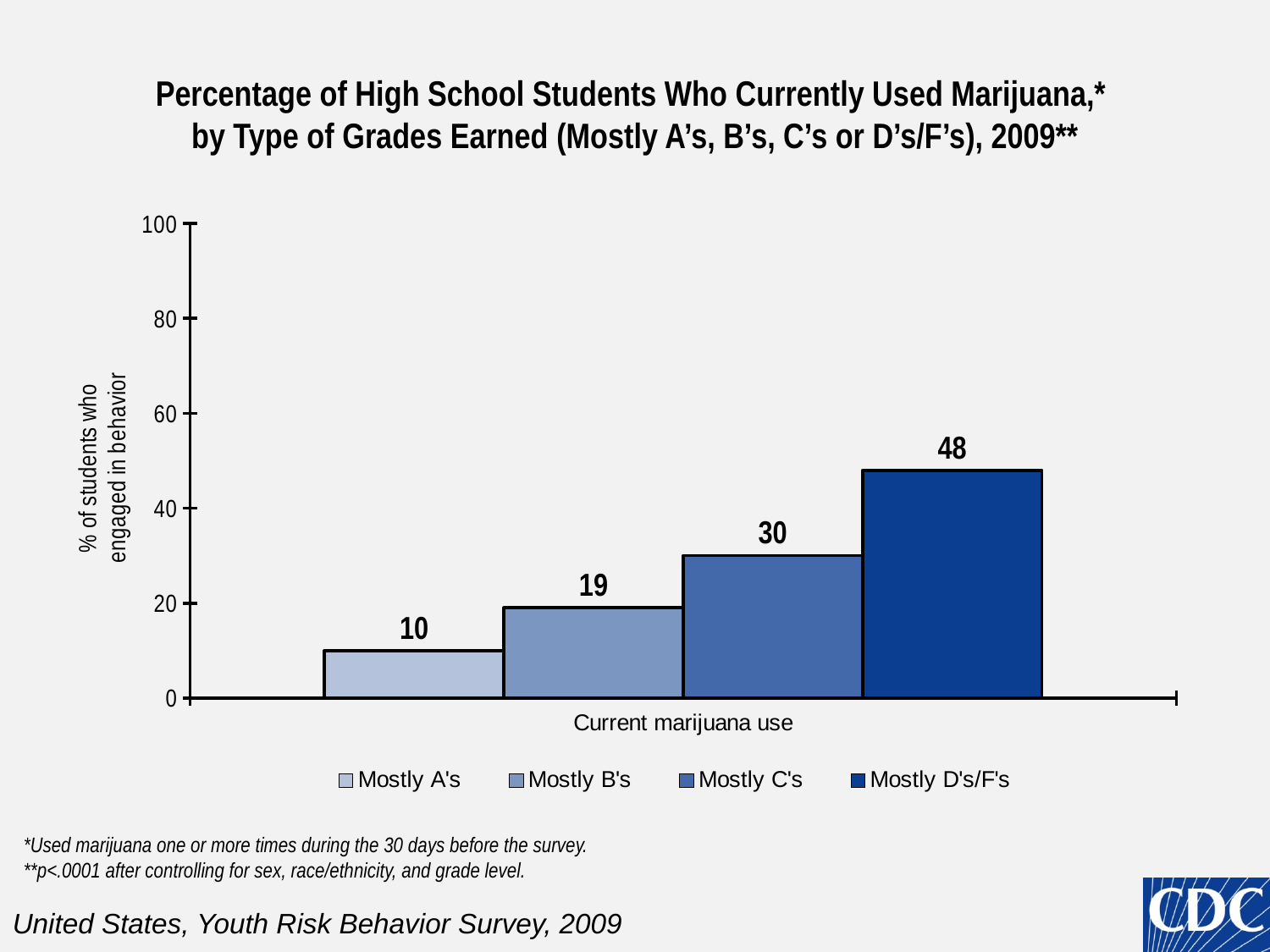
Which is larger, the value for Mostly B's or the value for Mostly C's? Mostly C's What is the value for Mostly A's? 10 What is the difference between the values for Mostly C's and Mostly B's? 11 What is the difference between the values for Mostly D's/F's and Mostly A's? 38 What kind of chart is shown on the slide? Bar chart What is the value for Mostly B's? 19 Which grade group has the lowest percentage of current marijuana use? Mostly A's Which grade group has the highest percentage of current marijuana use? Mostly D's/F's What is the value for Mostly C's? 30 What is the label on the y axis? % of students who engaged in behavior What is the value for Mostly D's/F's? 48 How many series does the legend list? 4